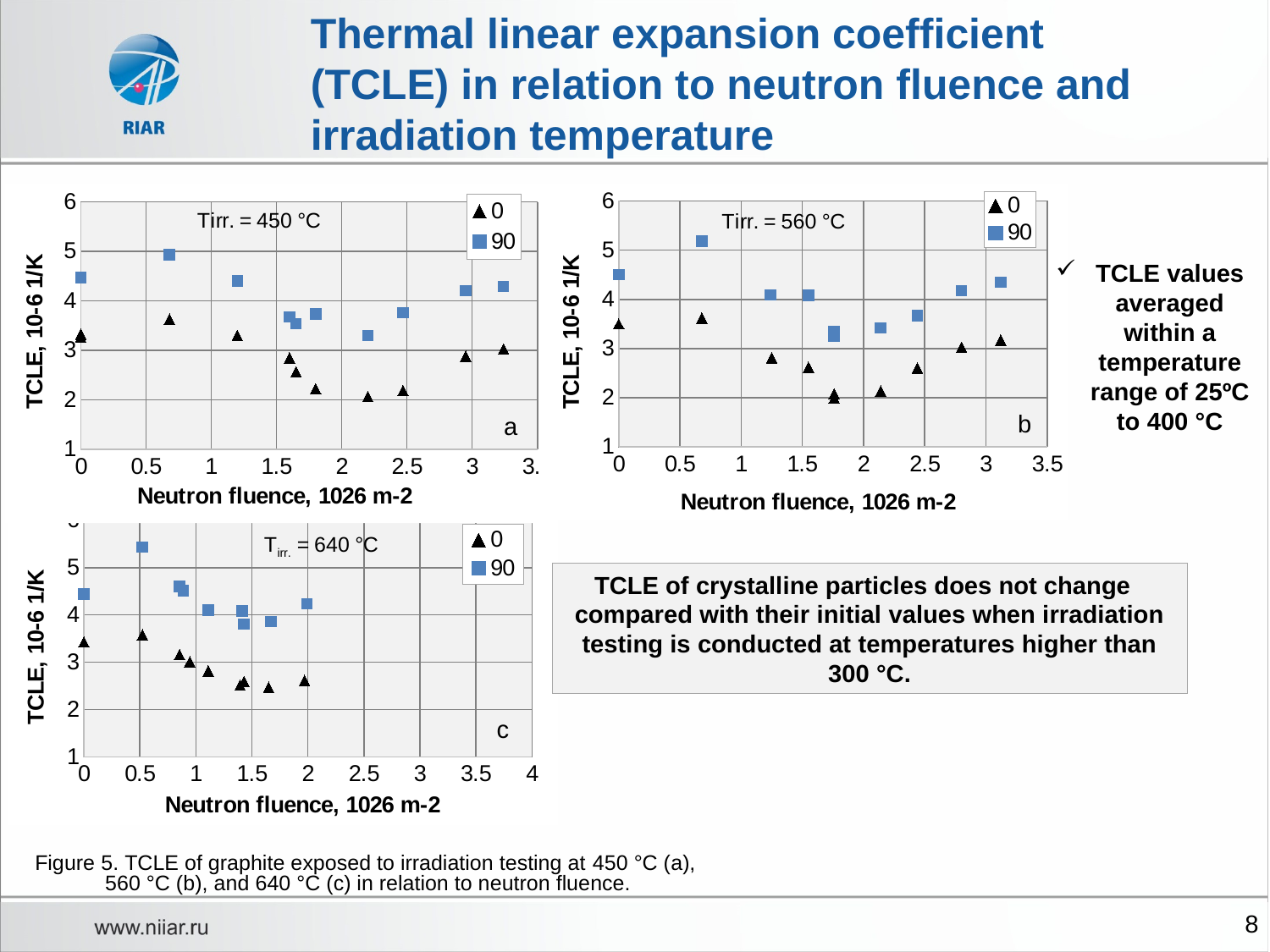
In chart a (Tirr. = 450 °C), is the value of the 90 series at a neutron fluence of about 0.7 greater or less than 4? greater In chart b (Tirr. = 560 °C), is the value of the 0 series at a neutron fluence of about 1.75 greater or less than 3? less In chart b (Tirr. = 560 °C), what are the two series named in the legend? 0 and 90 In chart c (Tirr. = 640 °C), is the value of the 90 series at a neutron fluence of about 0.5 greater or less than 5? greater In chart a (Tirr. = 450 °C), at a neutron fluence of 0, which series has the larger TCLE value, 0 or 90? 90 What kind of chart is chart a (Tirr. = 450 °C)? Scatter chart In chart a (Tirr. = 450 °C), how many series does the legend list? 2 What is the x-axis title of chart c (Tirr. = 640 °C)? Neutron fluence, 1026 m-2 How many charts are shown on the slide? 3 In chart c (Tirr. = 640 °C), at a neutron fluence of about 1.65, which series has the larger TCLE value, 0 or 90? 90